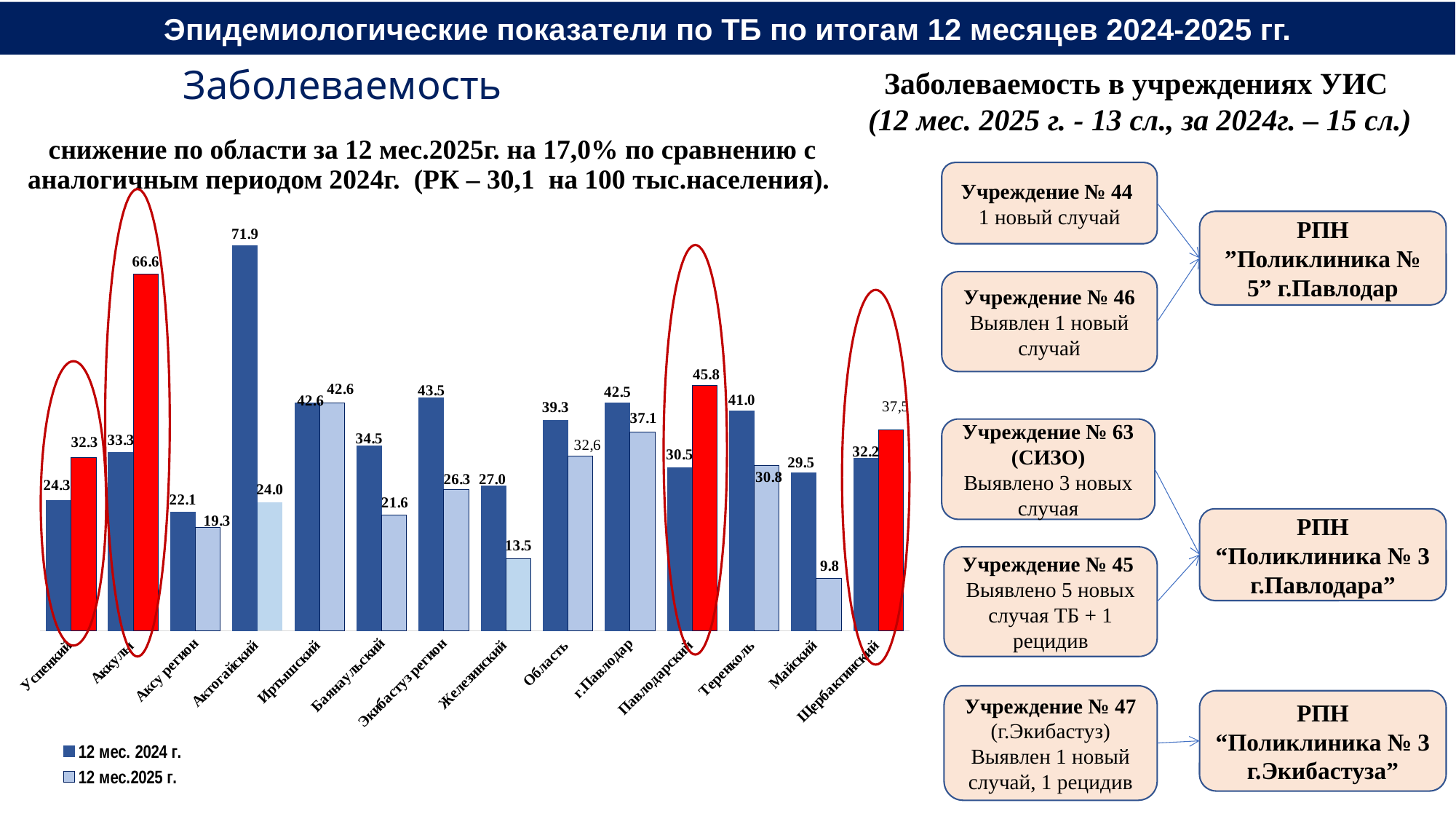
What is the value for Область for 12 мес. 2024 г.? 39.3 What is the value for Майский for 12 мес.2025 г.? 9.8 What is the difference between the 12 мес. 2024 г. and 12 мес.2025 г. values for Павлодарский? 15.3 What colour are the highlighted 12 мес.2025 г. bars for Успенский, Аккулы, Павлодарский and Щербактинский? red What is the value for Аккулы for 12 мес.2025 г.? 66.6 What kind of chart is shown on the slide? bar chart Which category has the lowest value for 12 мес.2025 г.? Майский Which category has the highest value for 12 мес. 2024 г.? Актогайский How many series does the chart legend list? 2 What is the value for Актогайский for 12 мес. 2024 г.? 71.9 Which is larger for Железинский: the 12 мес. 2024 г. value or the 12 мес.2025 г. value? 12 мес. 2024 г. How many categories are shown on the x axis of the chart? 14